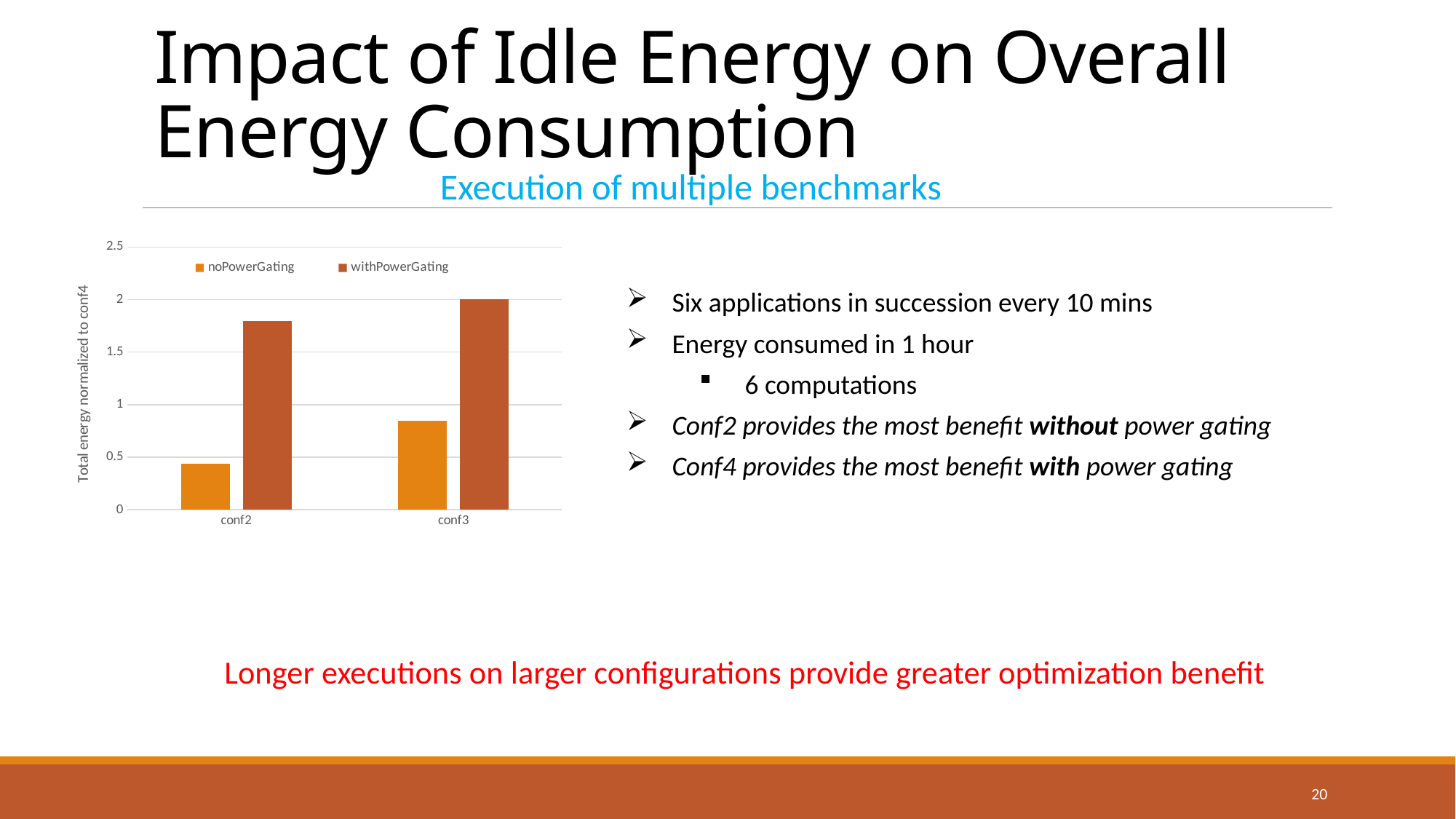
Is the noPowerGating value for conf3 greater or less than 0.5? greater Is the noPowerGating value for conf2 greater or less than 0.5? less How many configuration categories are shown on the x axis of the chart? 2 How many series does the chart's legend list? 2 What is the label on the chart's vertical axis? Total energy normalized to conf4 For conf2, which is larger: the noPowerGating value or the withPowerGating value? withPowerGating Is the withPowerGating value for conf2 greater or less than 1.5? greater Which configuration has the highest withPowerGating value? conf3 What kind of chart is shown on the slide? bar chart Do the noPowerGating values rise or fall from conf2 to conf3? rise Which configuration has the lowest noPowerGating value? conf2